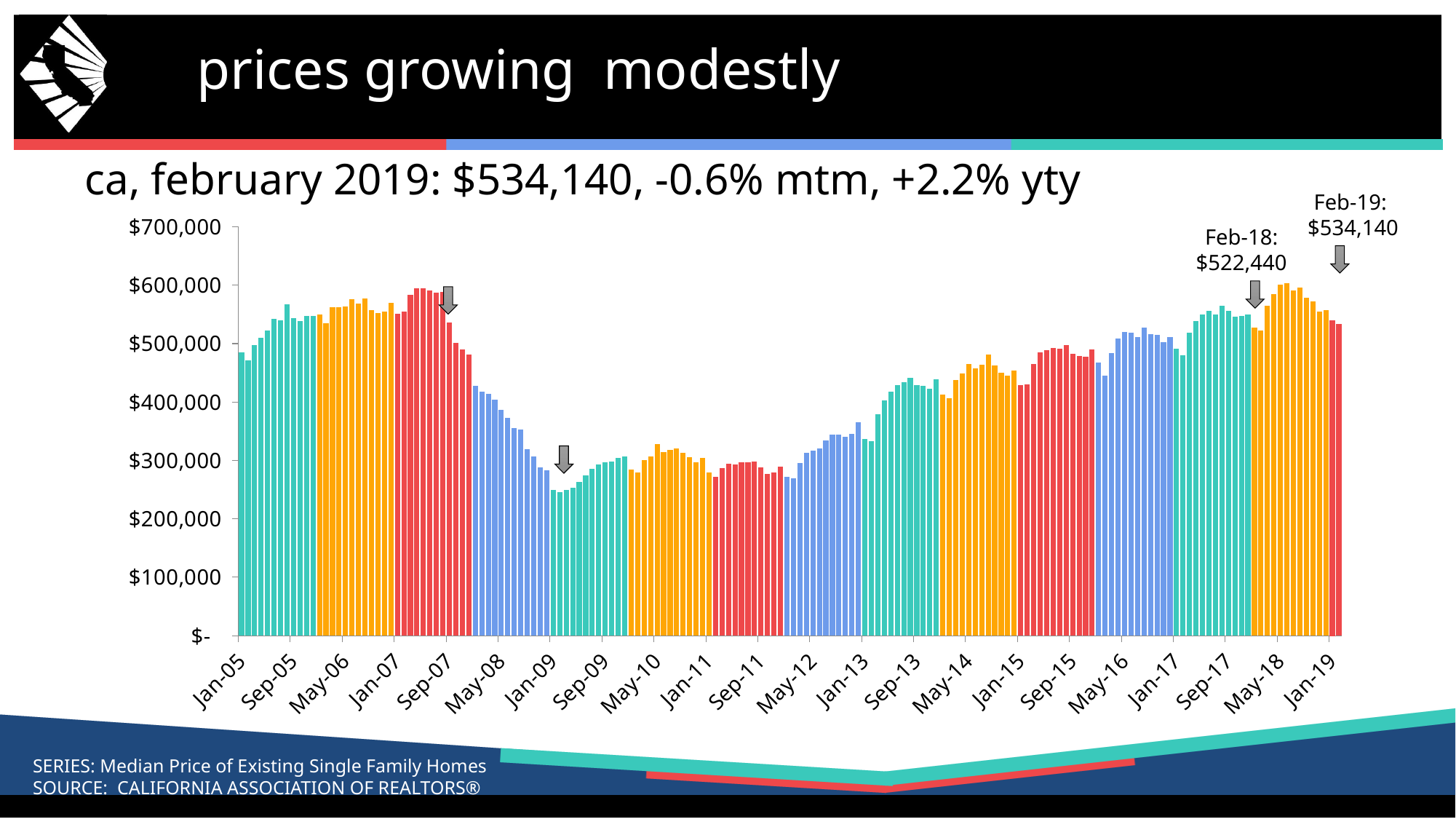
Is the value for Jan-13 greater or less than $300,000? greater Which is larger, the Feb-18 value or the Feb-19 value? Feb-19 Is the value for May-18 greater or less than $500,000? greater Is the value for Jan-05 greater or less than $400,000? greater What is the value labelled for Feb-18 on the chart? $522,440 Do the values rise or fall between Sep-07 and Jan-09? fall What is the difference between the Feb-19 value and the Feb-18 value? $11,700 Do the values rise or fall between Jan-13 and Sep-13? rise What is the value labelled for Feb-19 on the chart? $534,140 What kind of chart is shown on the slide? bar chart What is the highest tick shown on the y axis? $700,000